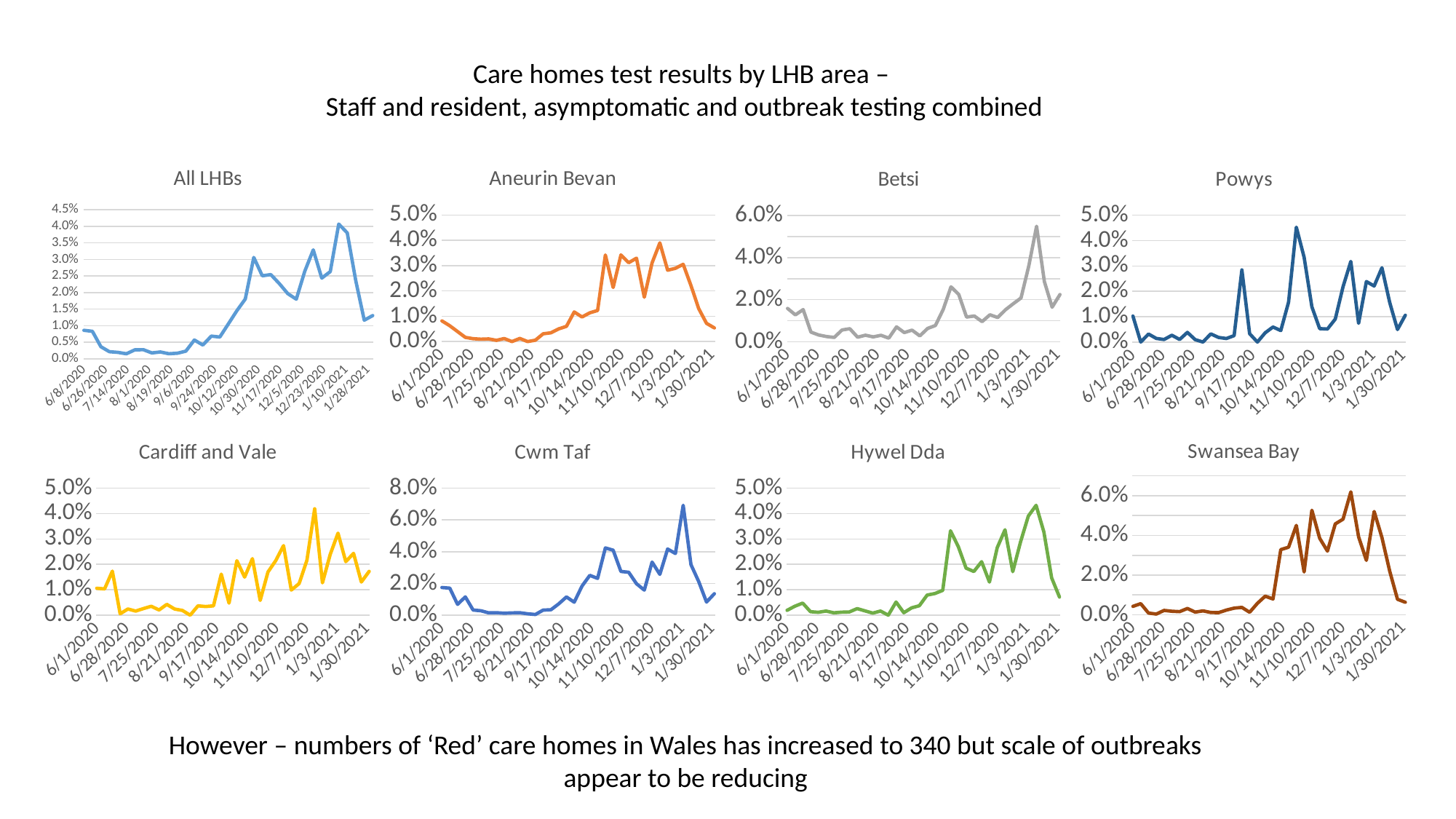
In the 'Aneurin Bevan' chart, is the value at 6/1/2020 greater or less than 1.0%? less In the 'Hywel Dda' chart, is the peak value greater or less than 3.0%? greater What is the highest value shown on the y-axis of the 'Cwm Taf' chart? 8.0% In the 'Powys' chart, is the peak value greater or less than 4.0%? greater How many charts are shown on the slide? 8 What kind of chart is the 'All LHBs' chart? line chart In the 'Swansea Bay' chart, do the values generally rise or fall between 6/1/2020 and 12/7/2020? rise In the 'All LHBs' chart, do the values rise or fall from 1/10/2021 to 1/28/2021? fall